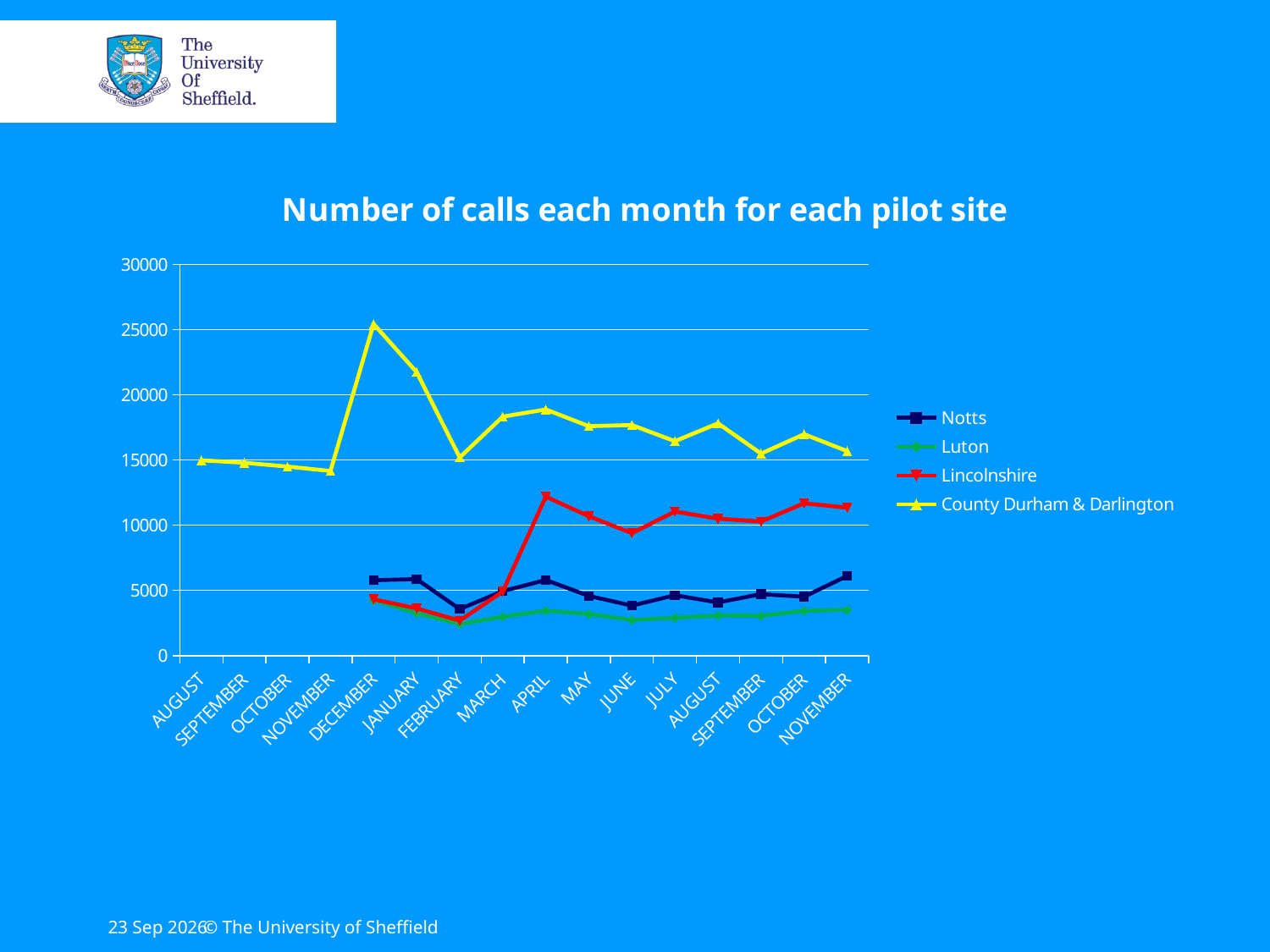
Which pilot site has the lowest line on the chart overall? Luton How many months are shown along the x axis? 16 What is the title of the chart? Number of calls each month for each pilot site Which pilot site has the highest number of calls in any month? County Durham & Darlington Is the value for Luton in February greater or less than 5000? less Is the value for County Durham & Darlington in December greater or less than 20000? greater Does the County Durham & Darlington line rise or fall from December to February? fall Is the value for Lincolnshire in April greater or less than 10000? greater In April, which has more calls: Lincolnshire or Notts? Lincolnshire What kind of chart is shown on the slide? line chart How many series does the legend list? 4 In which month does County Durham & Darlington reach its highest number of calls? December